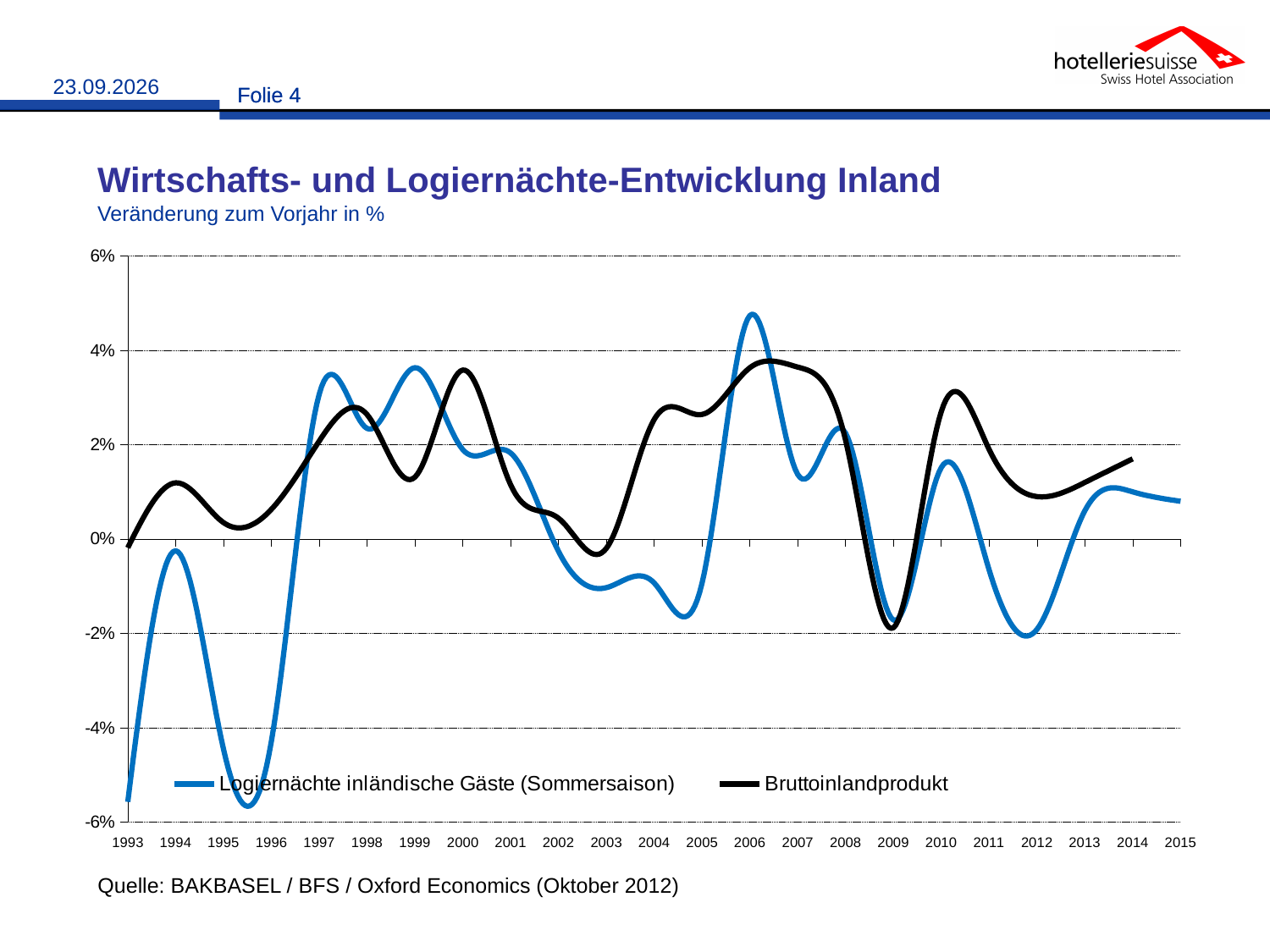
Is the value for Bruttoinlandprodukt in 2007 greater or less than 2%? greater What kind of chart is shown on the slide? Line chart In 2012, which series has the higher value: Logiernächte inländische Gäste (Sommersaison) or Bruttoinlandprodukt? Bruttoinlandprodukt What is the title of the chart? Wirtschafts- und Logiernächte-Entwicklung Inland Is the value for Logiernächte inländische Gäste (Sommersaison) in 2003 greater or less than 0%? less Does the Logiernächte inländische Gäste (Sommersaison) line rise or fall from 2010 to 2012? Fall Is the value for Logiernächte inländische Gäste (Sommersaison) in 1993 greater or less than -4%? less How many years are labelled on the x axis? 23 How many series does the legend list? 2 In 2006, which series has the higher value: Logiernächte inländische Gäste (Sommersaison) or Bruttoinlandprodukt? Logiernächte inländische Gäste (Sommersaison)